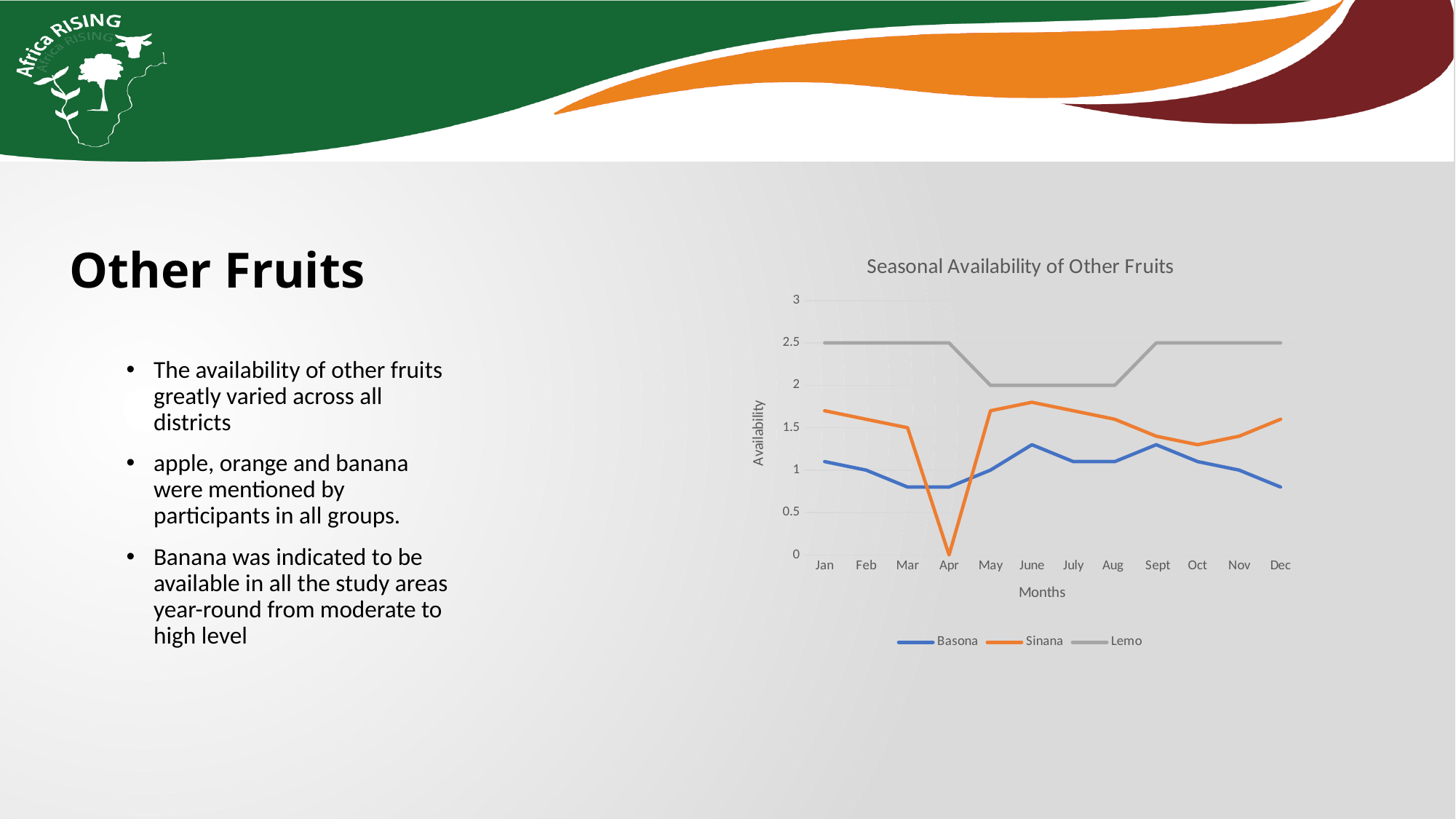
What is the availability value for Lemo in Jan? 2.5 What is the availability value for Lemo in June? 2 In which month is the Sinana series at its lowest? Apr What kind of chart is shown on the slide? line chart Is the value for Basona in June greater or less than 1? greater Is the value for Sinana in Jan greater or less than 1.5? greater How many series does the legend of the chart list? 3 What is the difference between the Lemo value in Jan and the Lemo value in June? 0.5 How many months are plotted along the x axis of the chart? 12 Which series has the higher value in Apr, Basona or Sinana? Basona What is the title of the chart? Seasonal Availability of Other Fruits What is the availability value for Sinana in Apr? 0